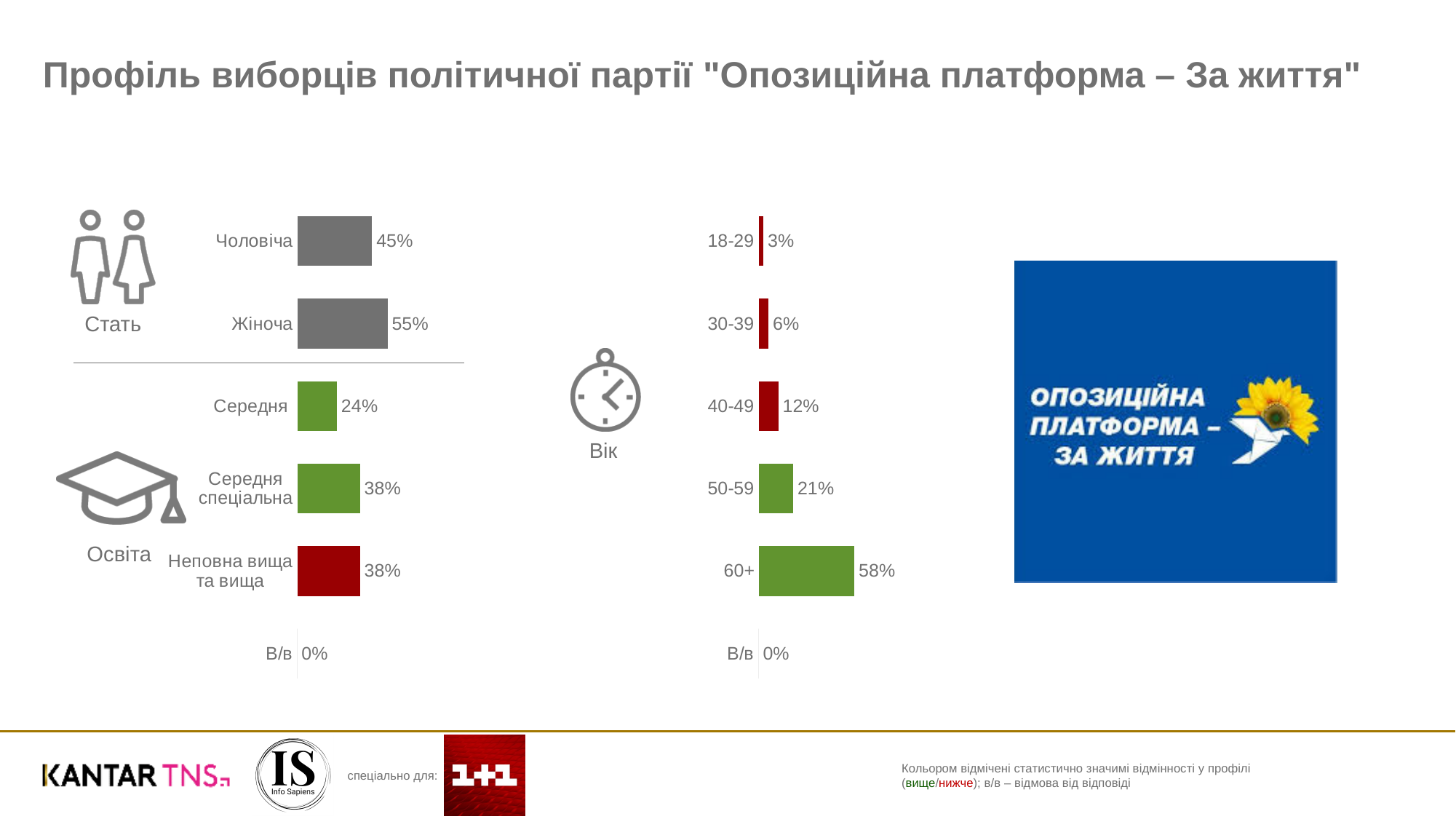
In the "Вік" chart in the middle, what is the value for "18-29"? 3% In the "Стать" chart on the left, what is the difference between "Жіноча" and "Чоловіча"? 10% In the "Освіта" chart on the left, which category has the lowest non-zero value? Середня In the "Освіта" chart on the left, what is the value for "Неповна вища та вища"? 38% In the "Освіта" chart on the left, what is the value for "Середня"? 24% What type of chart is the "Вік" chart in the middle? bar chart In the "Вік" chart in the middle, what is the difference between "50-59" and "40-49"? 9% In the "Вік" chart in the middle, what is the value for "60+"? 58% In the "Вік" chart in the middle, which age group has the highest value? 60+ In the "Вік" chart in the middle, do the values rise or fall as the age groups go from 18-29 to 60+? rise In the "Стать" chart on the left, what is the value for "Жіноча"? 55% In the "Стать" chart on the left, what is the value for "Чоловіча"? 45%